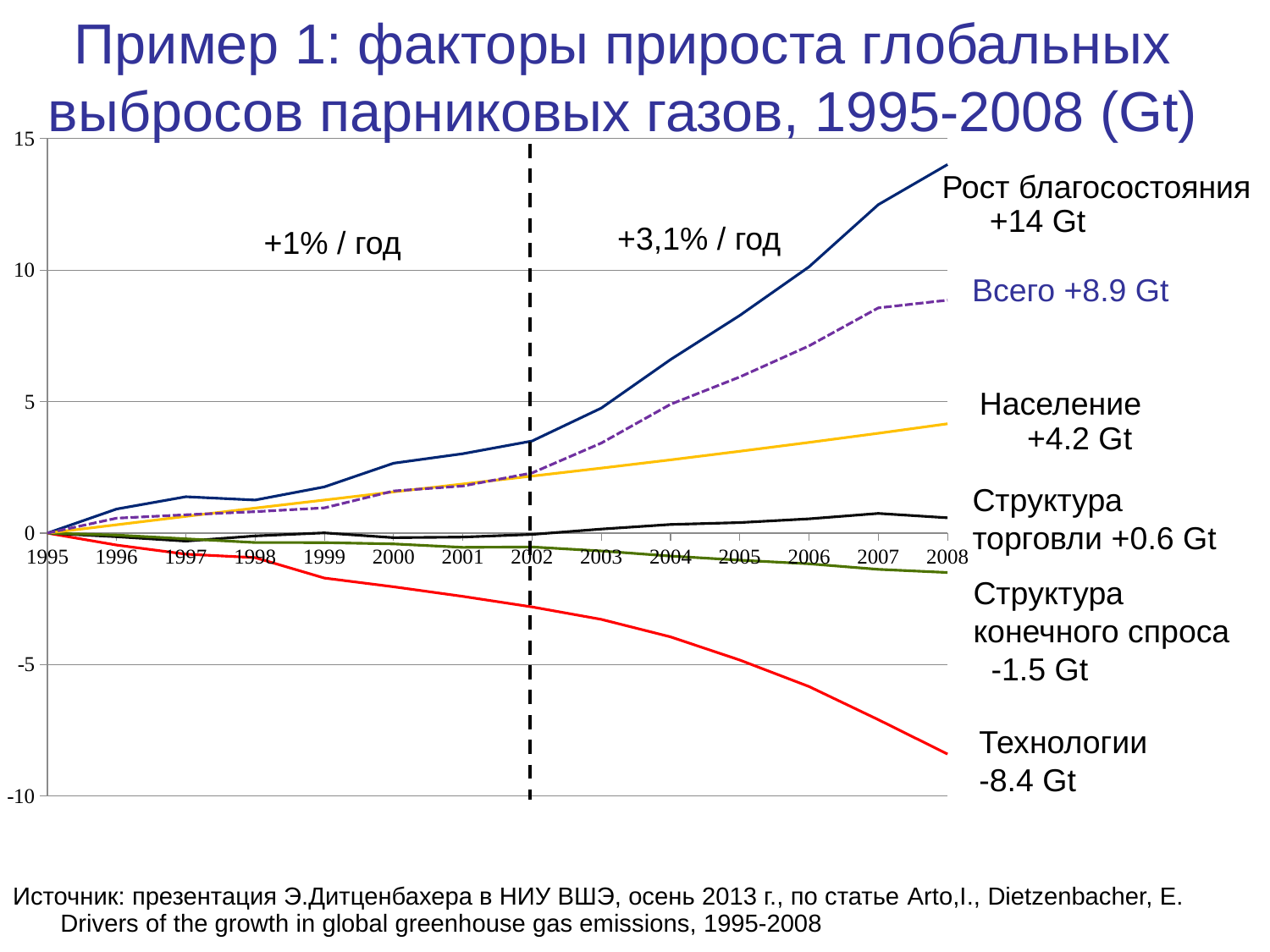
What is the value labelled for Всего? +8.9 Gt What is the value labelled for Население at the end of the period? +4.2 Gt What is the 2008 value shown for Технологии? -8.4 Gt What is the difference between the 2008 values for Рост благосостояния and Население? 9.8 Gt What is the 2008 value shown for Рост благосостояния? +14 Gt Which line ends at the highest value in 2008? Рост благосостояния Is the value for Рост благосостояния in 2002 greater or less than 5? less What annual growth rate is annotated for the period after 2002? +3,1% / год Which has the larger absolute 2008 value, Структура торговли or Структура конечного спроса? Структура конечного спроса Which line ends at the lowest value in 2008? Технологии What kind of chart is shown on the slide? line chart How many years are shown on the x axis? 14